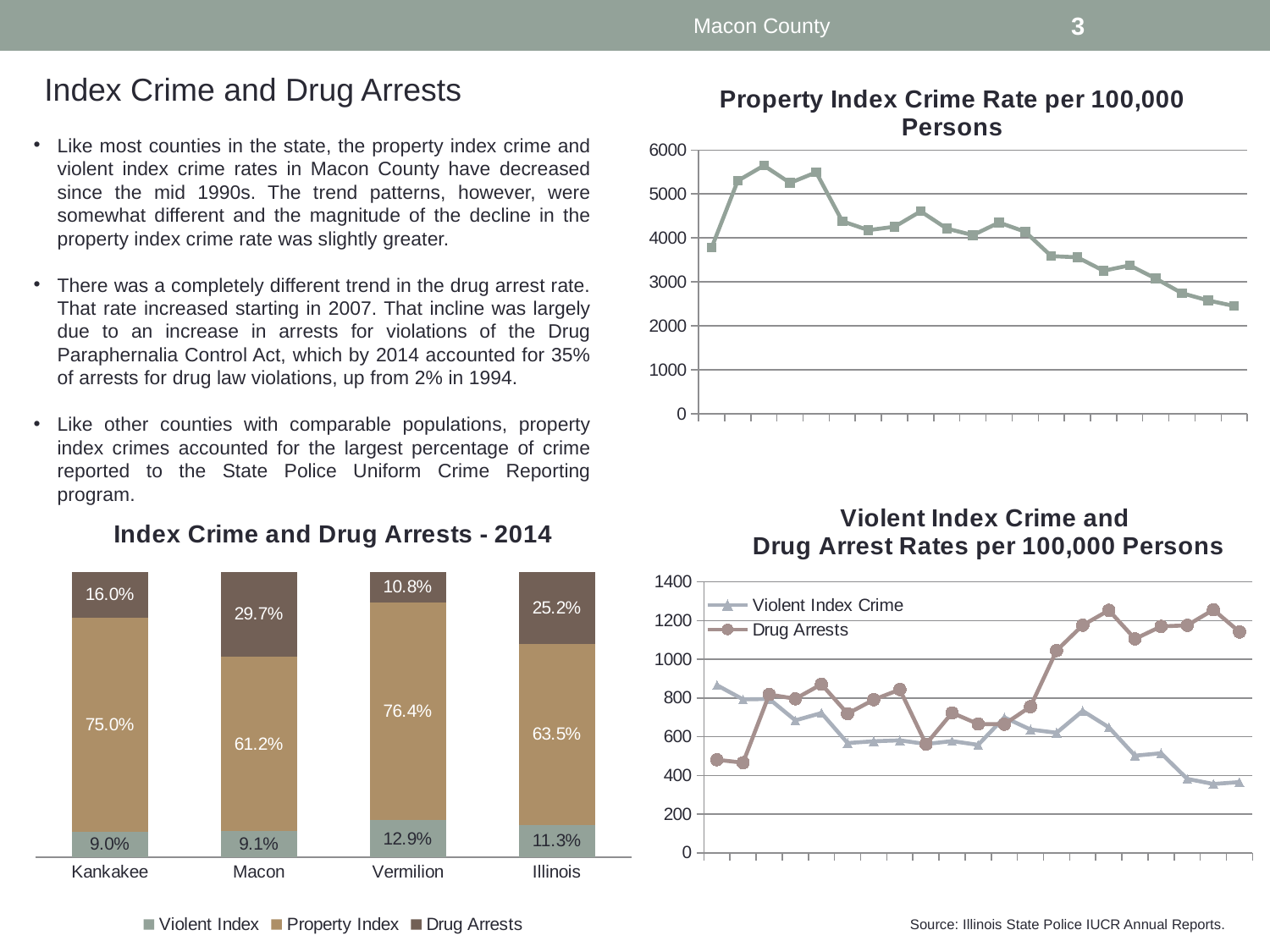
In the 'Index Crime and Drug Arrests - 2014' chart, what is the difference between the Property Index percentages for Kankakee and Macon? 13.8 percentage points How many series does the legend of the 'Violent Index Crime and Drug Arrest Rates per 100,000 Persons' chart list? 2 In the 'Index Crime and Drug Arrests - 2014' chart, what is the Property Index percentage for Macon? 61.2% How many categories are shown on the x axis of the 'Index Crime and Drug Arrests - 2014' chart? 4 What kind of chart is 'Index Crime and Drug Arrests - 2014'? Stacked bar chart In the 'Index Crime and Drug Arrests - 2014' chart, which is larger: the Drug Arrests percentage for Macon or for Kankakee? Macon In the 'Index Crime and Drug Arrests - 2014' chart, what is the Drug Arrests percentage for Illinois? 25.2% In the 'Index Crime and Drug Arrests - 2014' chart, which county has the highest Property Index percentage? Vermilion How many series does the legend of the 'Index Crime and Drug Arrests - 2014' chart list? 3 In the 'Property Index Crime Rate per 100,000 Persons' chart, is the last plotted value greater or less than 3000? less In the 'Violent Index Crime and Drug Arrest Rates per 100,000 Persons' chart, is the last Drug Arrests value greater or less than 1000? greater In the 'Index Crime and Drug Arrests - 2014' chart, which category has the lowest Drug Arrests percentage? Vermilion